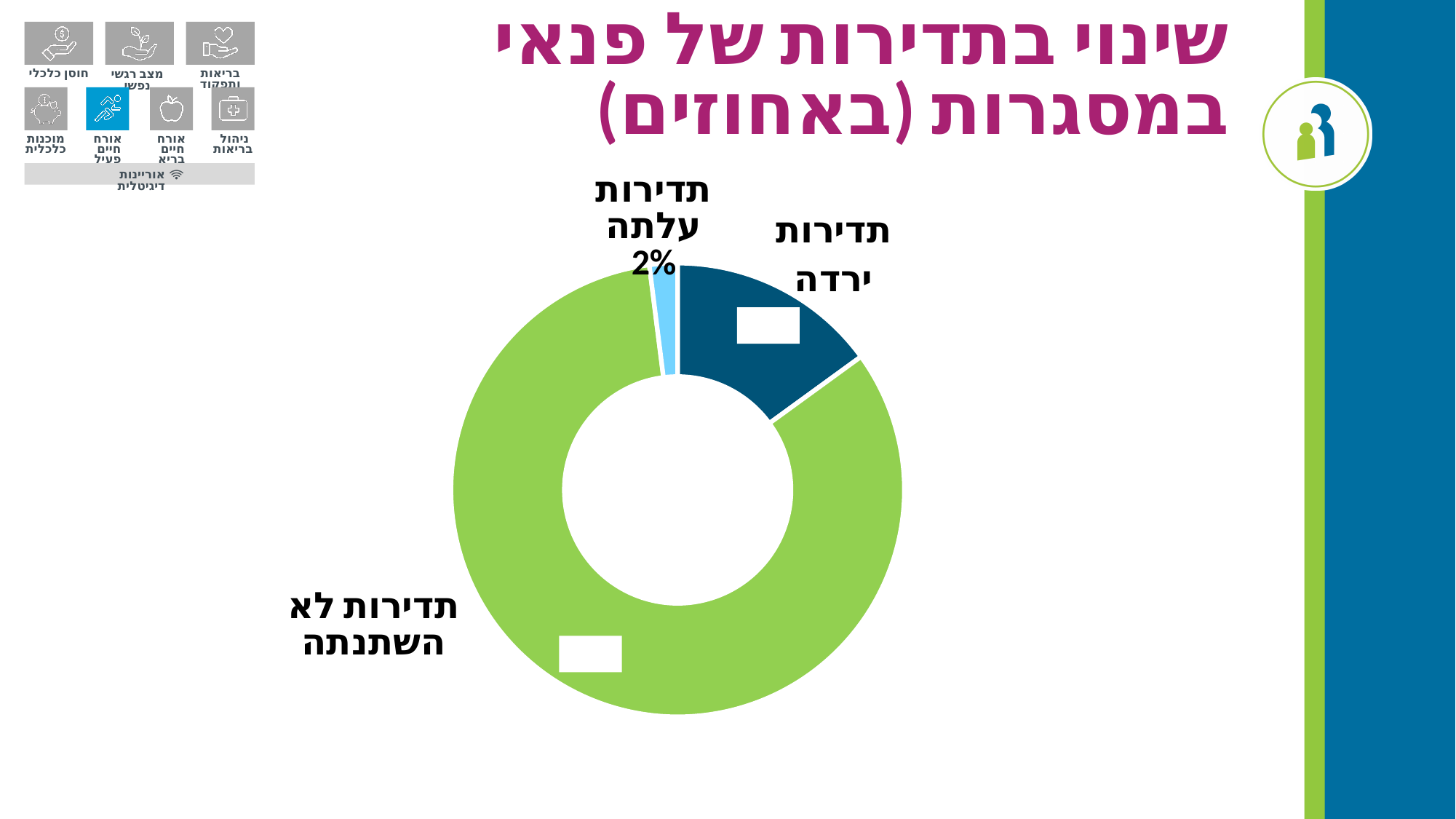
How many categories (slices) does the chart show? 3 What kind of chart is shown on the slide? Pie chart (donut) Which slice is larger: תדירות ירדה or תדירות עלתה? תדירות ירדה Which category has the largest slice in the chart? תדירות לא השתנתה What is the value shown for תדירות עלתה? 2% What colour is the תדירות לא השתנתה slice? Green Which category has the smallest slice in the chart? תדירות עלתה What is the title of the slide's chart? שינוי בתדירות של פנאי במסגרות (באחוזים) What share of the pie does the תדירות עלתה slice represent? 2% Which slice is larger: תדירות ירדה or תדירות לא השתנתה? תדירות לא השתנתה